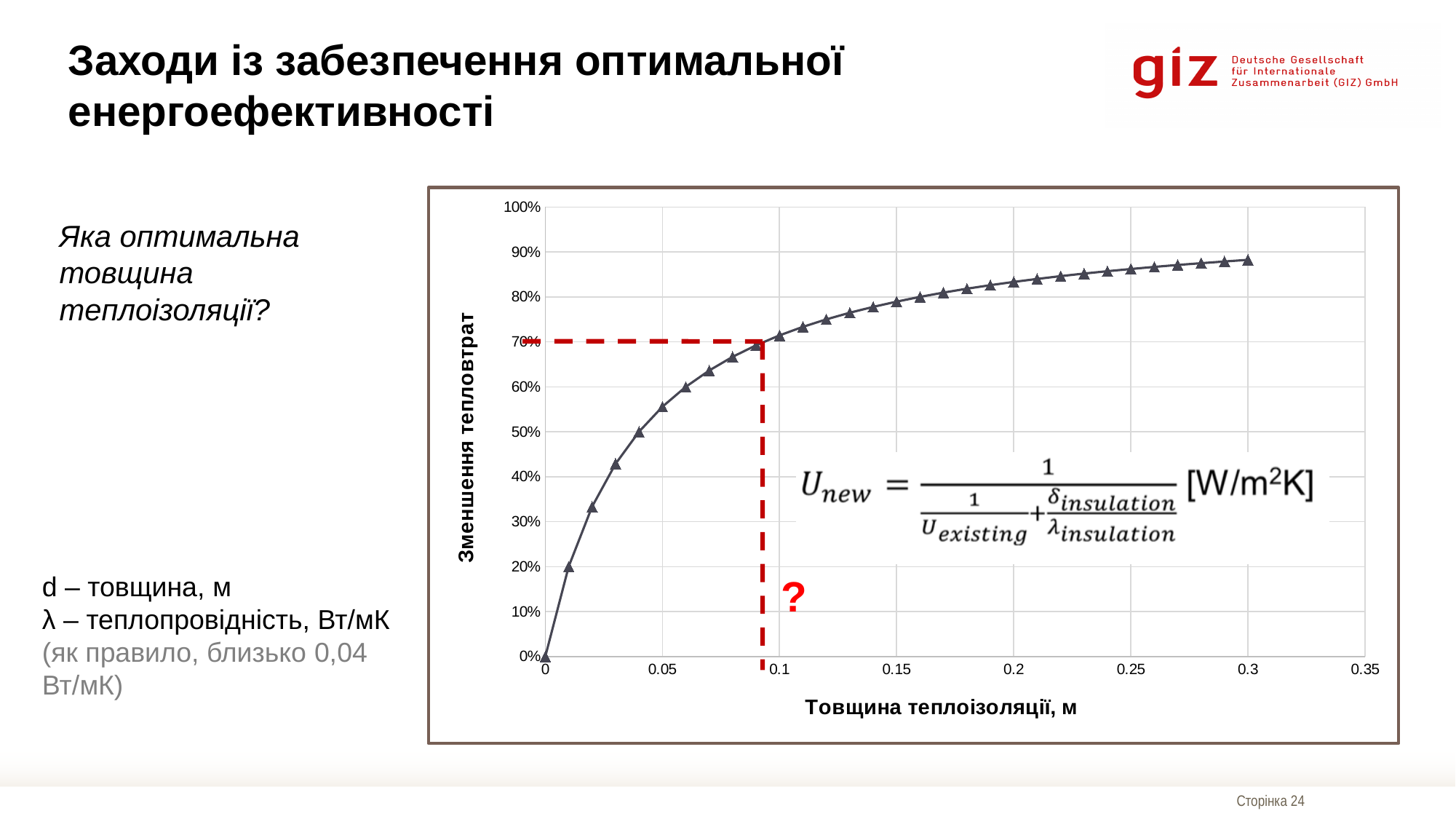
Is the value at a thickness of 0.15 m greater or less than 70%? greater Do the values rise or fall as insulation thickness increases along the x axis? rise At which insulation thickness is the reduction in heat loss highest? 0.3 At which insulation thickness is the reduction in heat loss lowest? 0 Which is larger: the value at 0.05 m or the value at 0.2 m? 0.2 m Is the value at a thickness of 0.01 m greater or less than 30%? less Is the value at a thickness of 0.3 m greater or less than 80%? greater What is the title of the x axis of the chart? Товщина теплоізоляції, м What is the title of the y axis of the chart? Зменшення тепловтрат What kind of chart is shown on the slide? line chart What is the value of Зменшення тепловтрат at a thickness of 0 m? 0%